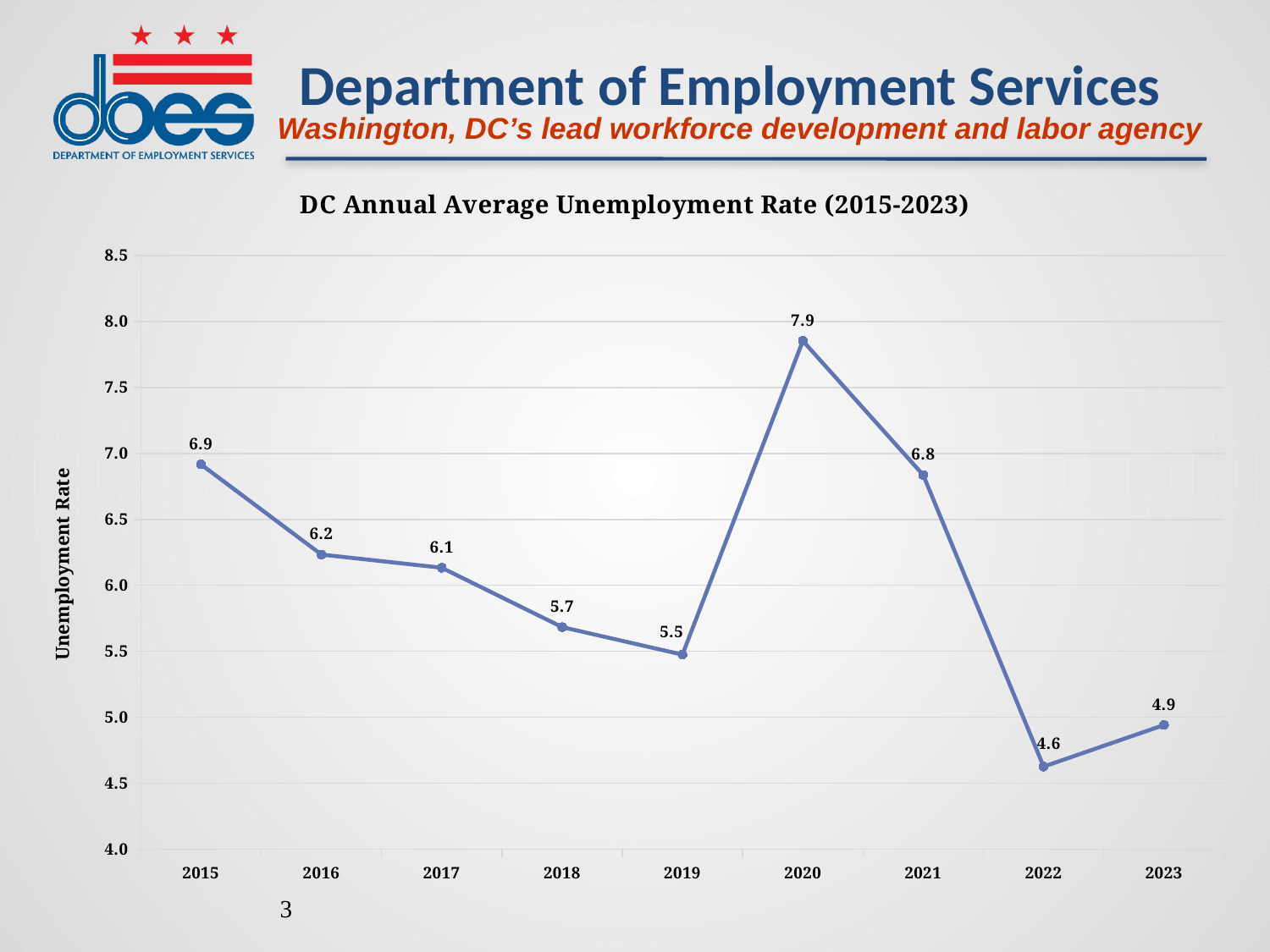
What is the difference between the unemployment rate in 2015 and in 2019? 1.4 Which year has the highest unemployment rate? 2020 What is the difference between the unemployment rate in 2020 and in 2021? 1.1 Does the unemployment rate rise or fall from 2015 to 2019? Fall What is the unemployment rate for 2023? 4.9 Is the value for 2021 greater or less than 6.5? greater Which year has the lowest unemployment rate? 2022 What kind of chart is shown on the slide? Line chart Which year has a higher unemployment rate, 2017 or 2018? 2017 What is the unemployment rate for 2015? 6.9 How many years are plotted on the chart? 9 What is the unemployment rate for 2020? 7.9